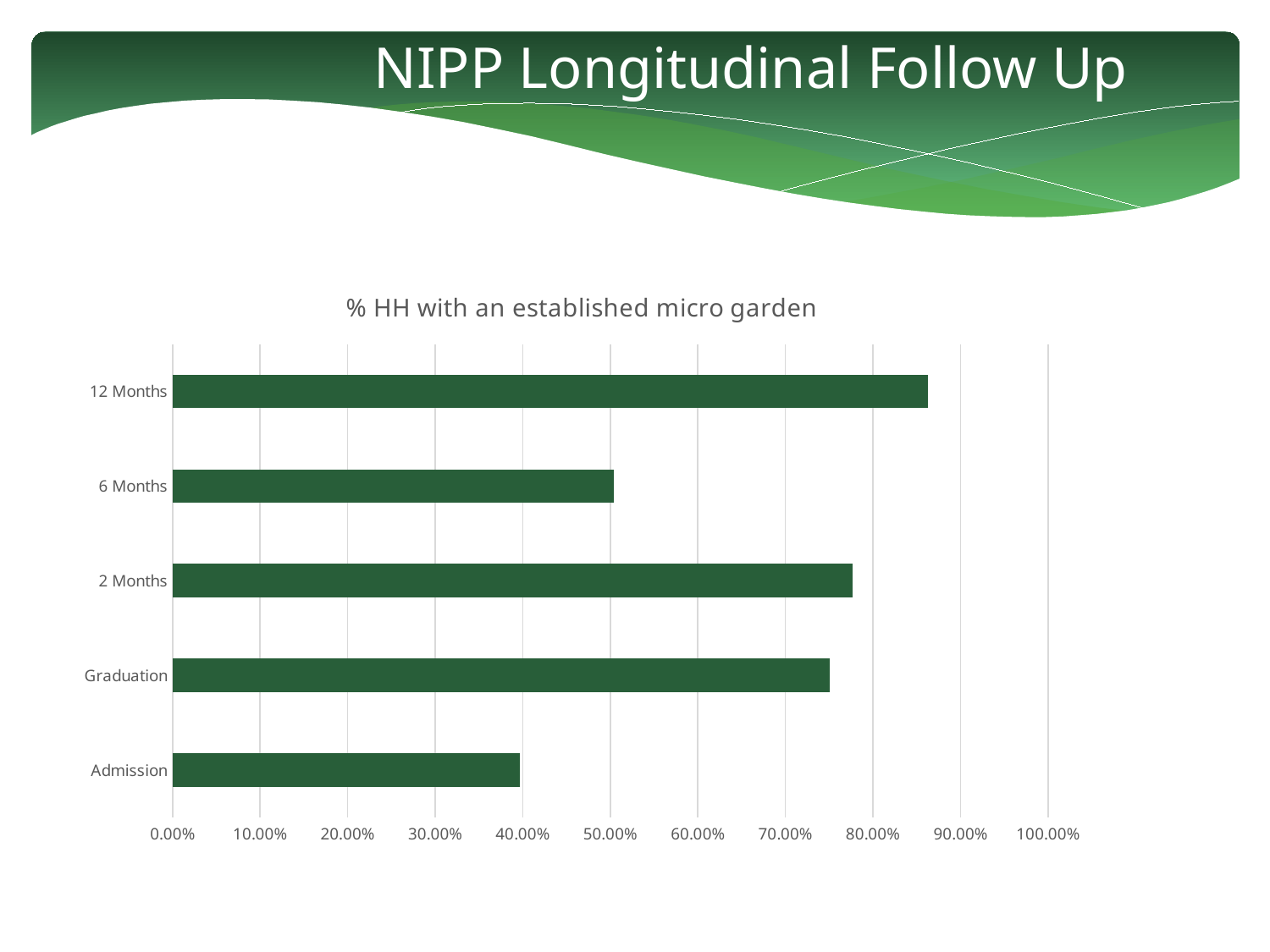
Is the value for Graduation greater or less than 80.00%? less What is the title of the chart? % HH with an established micro garden Is the value for 2 Months greater or less than 70.00%? greater Is the value for Admission greater or less than 30.00%? greater Which category has the highest value? 12 Months Which is larger, the value for 6 Months or the value for 12 Months? 12 Months How many categories are shown on the chart? 5 Which is larger, the value for Admission or the value for Graduation? Graduation Which category has the lowest value? Admission What kind of chart is shown on the slide? bar chart